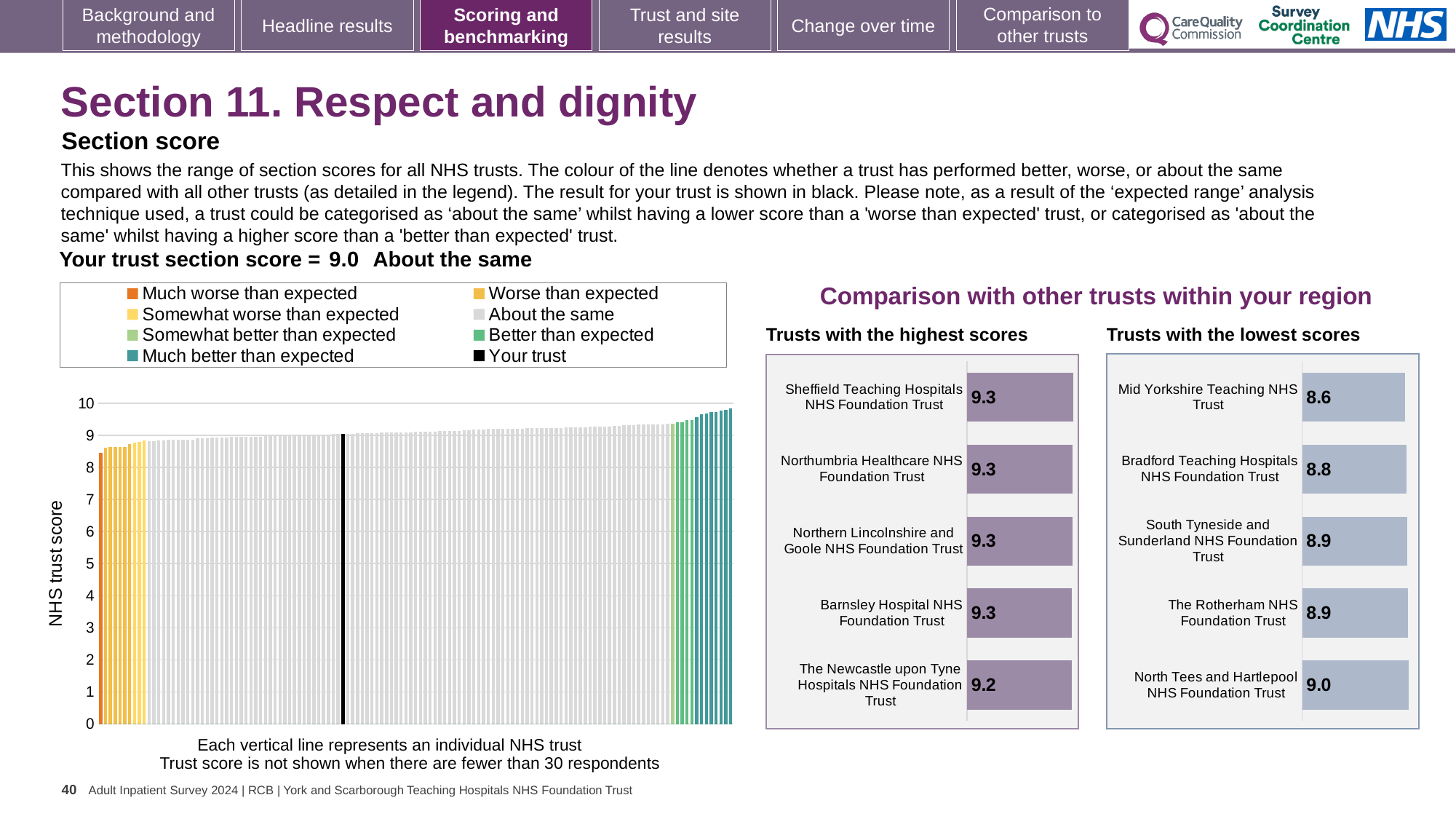
In the 'Trusts with the lowest scores' chart, what is the difference between the scores of North Tees and Hartlepool NHS Foundation Trust and Mid Yorkshire Teaching NHS Trust? 0.4 In the 'Trusts with the highest scores' chart, what is the difference between the scores of Barnsley Hospital NHS Foundation Trust and The Newcastle upon Tyne Hospitals NHS Foundation Trust? 0.1 In the 'Trusts with the lowest scores' chart, which has the larger score: Bradford Teaching Hospitals NHS Foundation Trust or Mid Yorkshire Teaching NHS Trust? Bradford Teaching Hospitals NHS Foundation Trust In the 'Trusts with the lowest scores' chart, what is the score for Mid Yorkshire Teaching NHS Trust? 8.6 In the large chart on the left showing NHS trust scores, what kind of chart is it? Bar chart In the 'Trusts with the highest scores' chart, what is the score for Sheffield Teaching Hospitals NHS Foundation Trust? 9.3 In the 'Trusts with the lowest scores' chart, which trust has the lowest score? Mid Yorkshire Teaching NHS Trust In the 'Trusts with the highest scores' chart, how many trusts are shown? 5 In the large chart on the left showing NHS trust scores, do the values rise or fall from left to right along the x axis? Rise In the 'Trusts with the lowest scores' chart, which trust has the highest score? North Tees and Hartlepool NHS Foundation Trust In the 'Trusts with the highest scores' chart, which trust has the lowest score? The Newcastle upon Tyne Hospitals NHS Foundation Trust In the large chart on the left showing NHS trust scores, how many entries does the legend list? 8